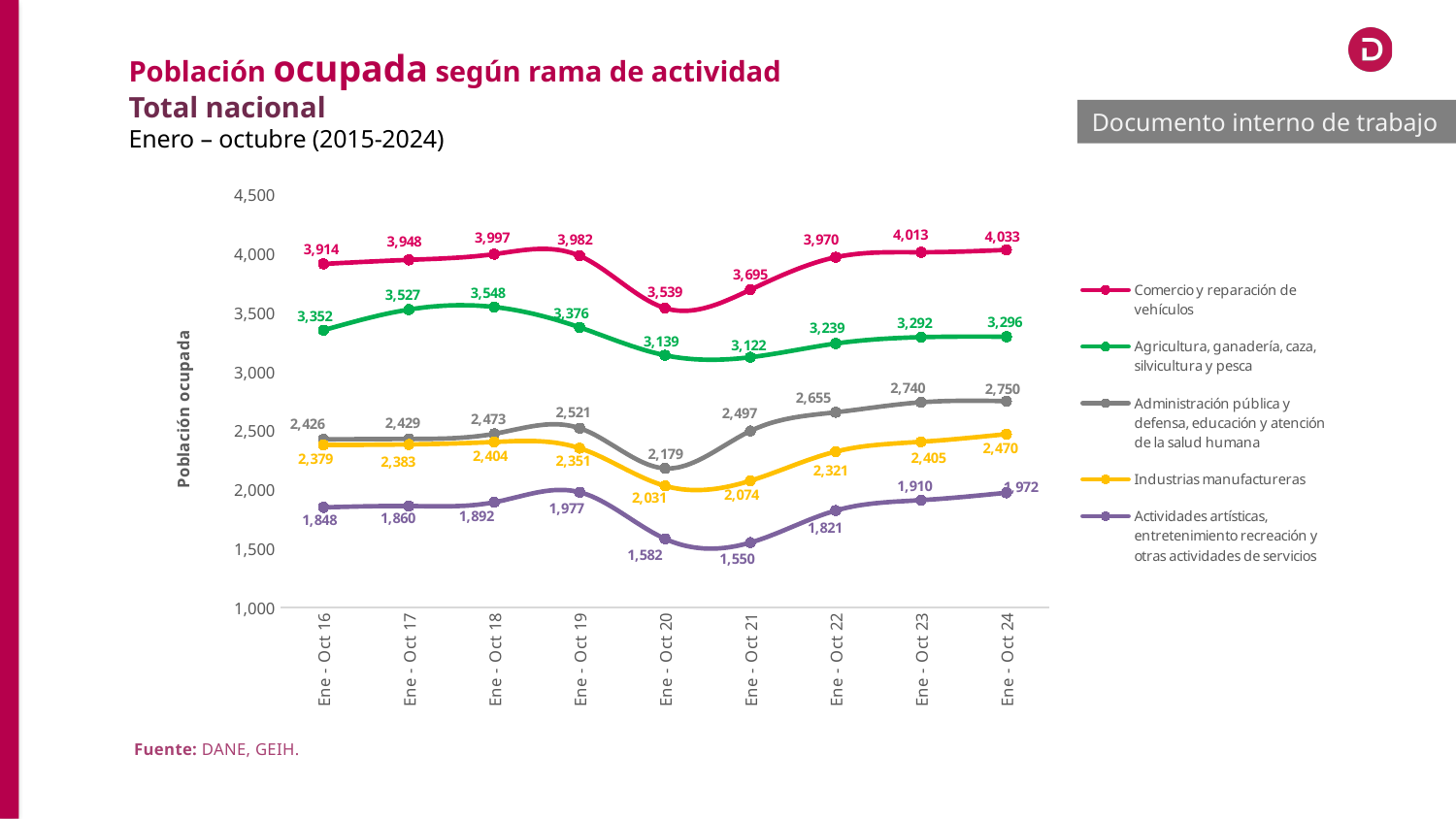
What is the value for Industrias manufactureras in Ene - Oct 16? 2,379 What is the label of the y axis? Población ocupada How many periods are shown along the x axis? 9 Is the value for Actividades artísticas, entretenimiento recreación y otras actividades de servicios in Ene - Oct 20 greater or less than 2,000? less What is the difference between the Administración pública, defensa, educación y atención de la salud humana values in Ene - Oct 24 and Ene - Oct 20? 571 What type of chart is shown on the slide? Line chart Which is larger in Ene - Oct 19: Administración pública, defensa, educación y atención de la salud humana or Industrias manufactureras? Administración pública, defensa, educación y atención de la salud humana What is the value for Comercio y reparación de vehículos in Ene - Oct 24? 4,033 In which period is the value for Comercio y reparación de vehículos highest? Ene - Oct 24 What is the value for Agricultura, ganadería, caza, silvicultura y pesca in Ene - Oct 20? 3,139 How many series does the legend list? 5 In which period is the value for Actividades artísticas, entretenimiento recreación y otras actividades de servicios lowest? Ene - Oct 21